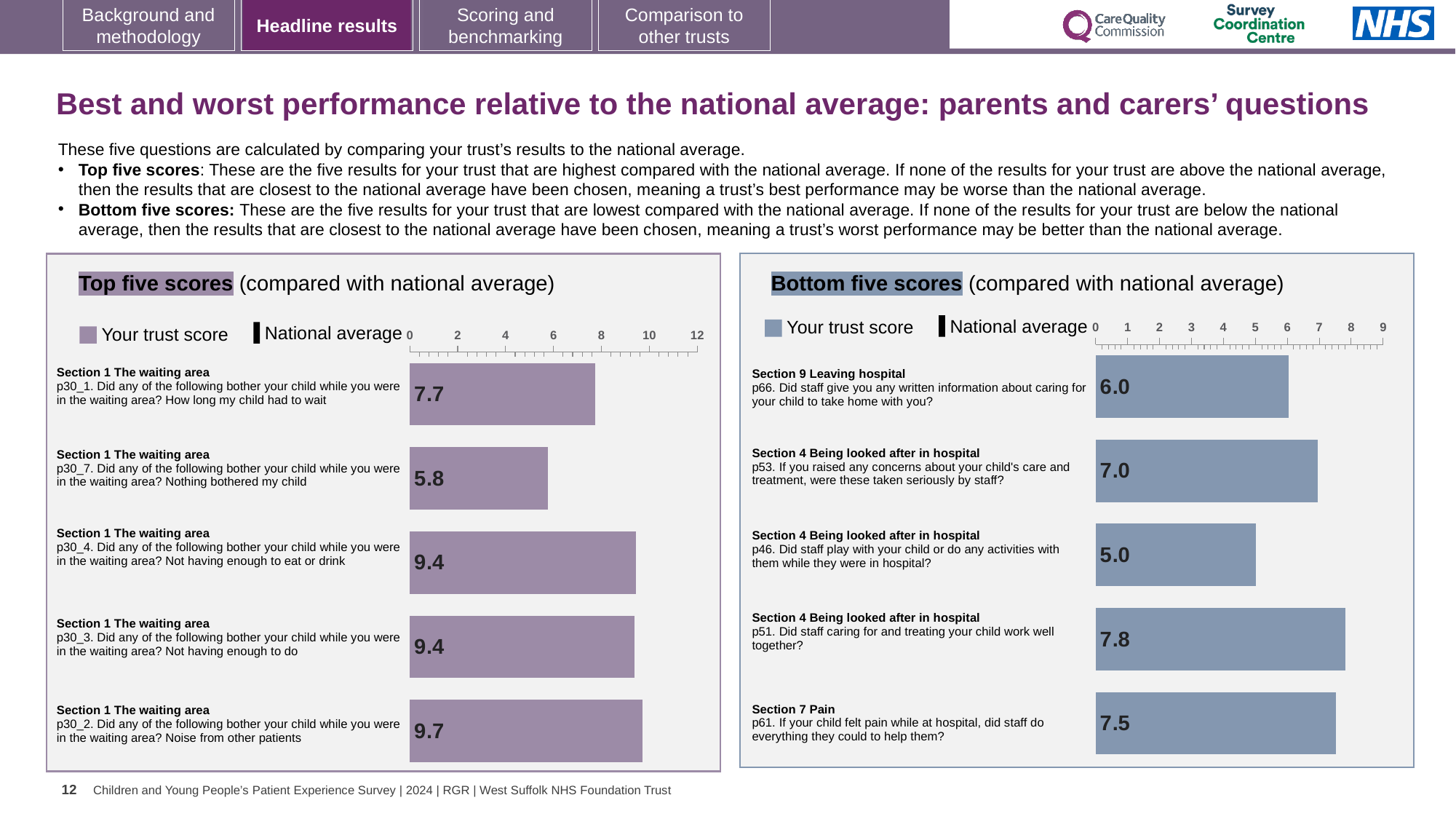
In the Top five scores chart, what is the difference between the trust scores for p30_2 and p30_7? 3.9 How many bars are plotted in the Top five scores chart? 5 In the Top five scores chart, which question has the highest trust score? p30_2. Noise from other patients (9.7) In the Bottom five scores chart, which question has the highest trust score? p51. Did staff caring for and treating your child work well together? (7.8) In the Top five scores chart, what is the trust score for p30_1 (How long my child had to wait)? 7.7 What type of chart is used for the Bottom five scores? Bar chart In the Bottom five scores chart, what is the trust score for p46 (Did staff play with your child or do any activities with them)? 5.0 In the Bottom five scores chart, what is the difference between the trust scores for p51 and p66? 1.8 How many entries does the legend of the Top five scores chart list? 2 In the Bottom five scores chart, which has the larger trust score: p53 or p61? p61 (7.5) In the Bottom five scores chart, which question has the lowest trust score? p46. Did staff play with your child or do any activities with them while they were in hospital? (5.0) In the Top five scores chart, which question has the lowest trust score? p30_7. Nothing bothered my child (5.8)